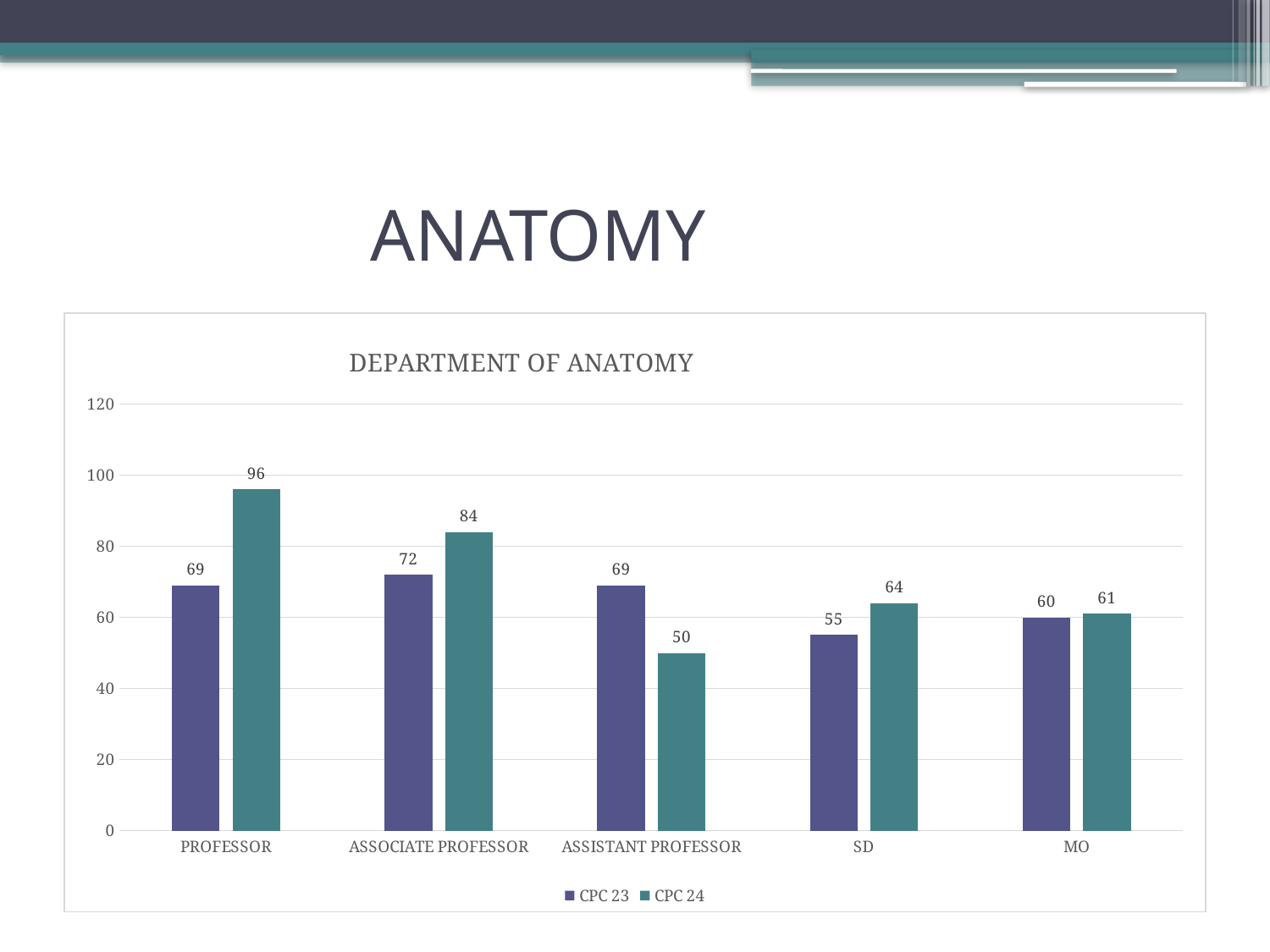
Which is larger for ASSISTANT PROFESSOR, the CPC 23 value or the CPC 24 value? CPC 23 What is the CPC 24 value for ASSISTANT PROFESSOR? 50 What is the CPC 24 value for PROFESSOR? 96 What is the difference between the CPC 24 and CPC 23 values for PROFESSOR? 27 What is the title of the chart? DEPARTMENT OF ANATOMY How many series does the legend list? 2 What kind of chart is shown on the slide? bar chart Is the CPC 24 value for ASSOCIATE PROFESSOR greater or less than 80? greater Which category has the lowest CPC 23 value? SD How many categories are shown on the x axis? 5 What is the CPC 23 value for SD? 55 Which category has the highest CPC 24 value? PROFESSOR